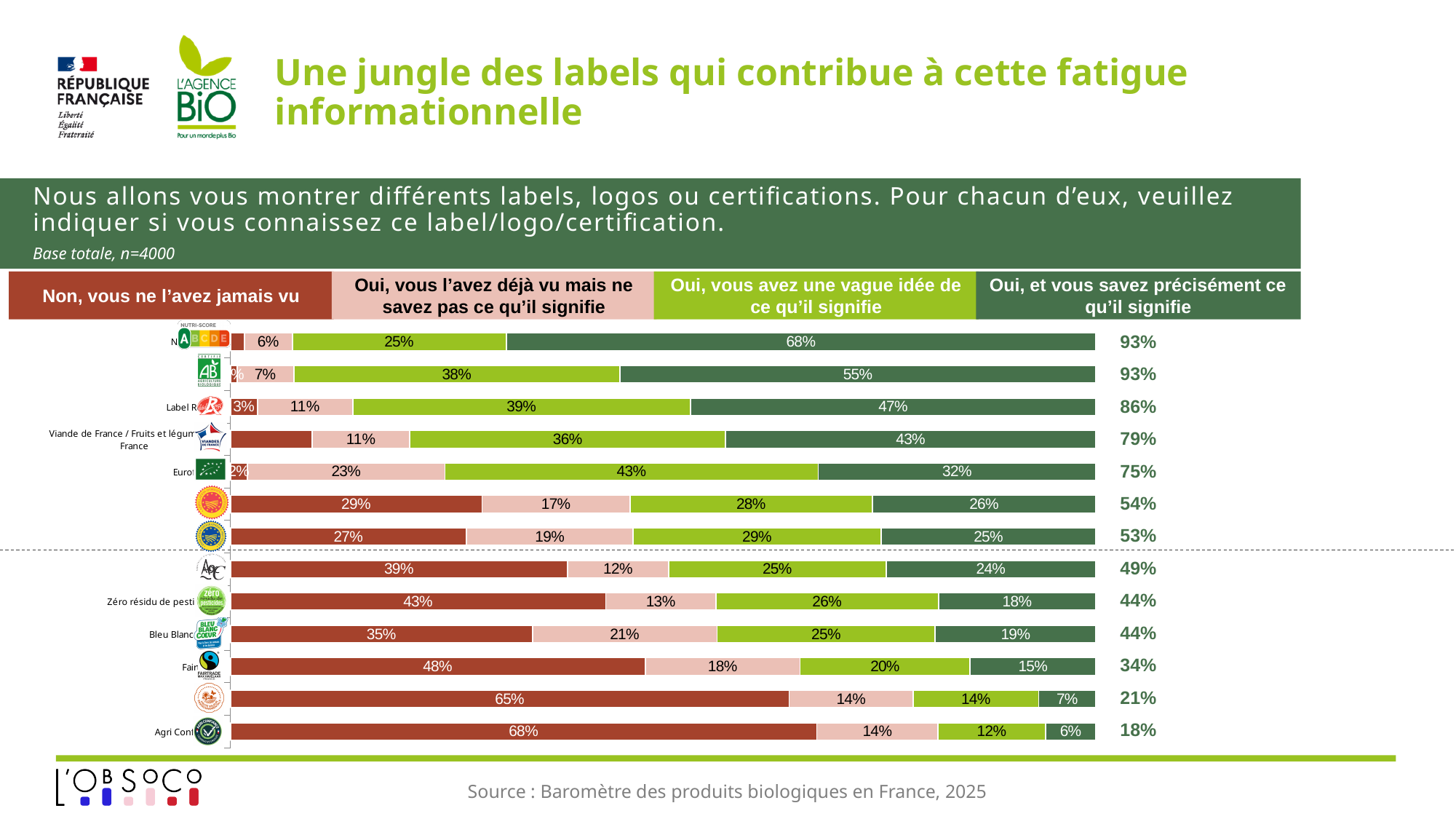
How many series does the legend list in the stacked bar chart? 4 For Label Rouge, what is the difference between the share who know precisely what it means (47%) and the share with a vague idea (39%)? 8 percentage points What percentage of respondents have never seen the Agri Confiance label ("Non, vous ne l'avez jamais vu")? 68% Which label has the highest share of respondents who know precisely what it means? Nutri-Score What percentage of respondents say they know precisely what the Nutri-Score label means ("Oui, et vous savez précisément ce qu'il signifie")? 68% What total percentage is shown at the right of the bar for Label Rouge? 86% What kind of chart is used to show the label recognition results? Stacked bar chart For "Viande de France / Fruits et légumes de France", what share has a vague idea of what the label means? 36% For Bleu Blanc Coeur, what share has already seen the label but does not know what it means? 21% How many labels/logos (rows) are plotted in the chart? 13 Which label has the highest share of respondents who have never seen it? Agri Confiance Which has a larger share of respondents who have never seen it: Bleu Blanc Coeur or Zéro résidu de pesticides? Zéro résidu de pesticides